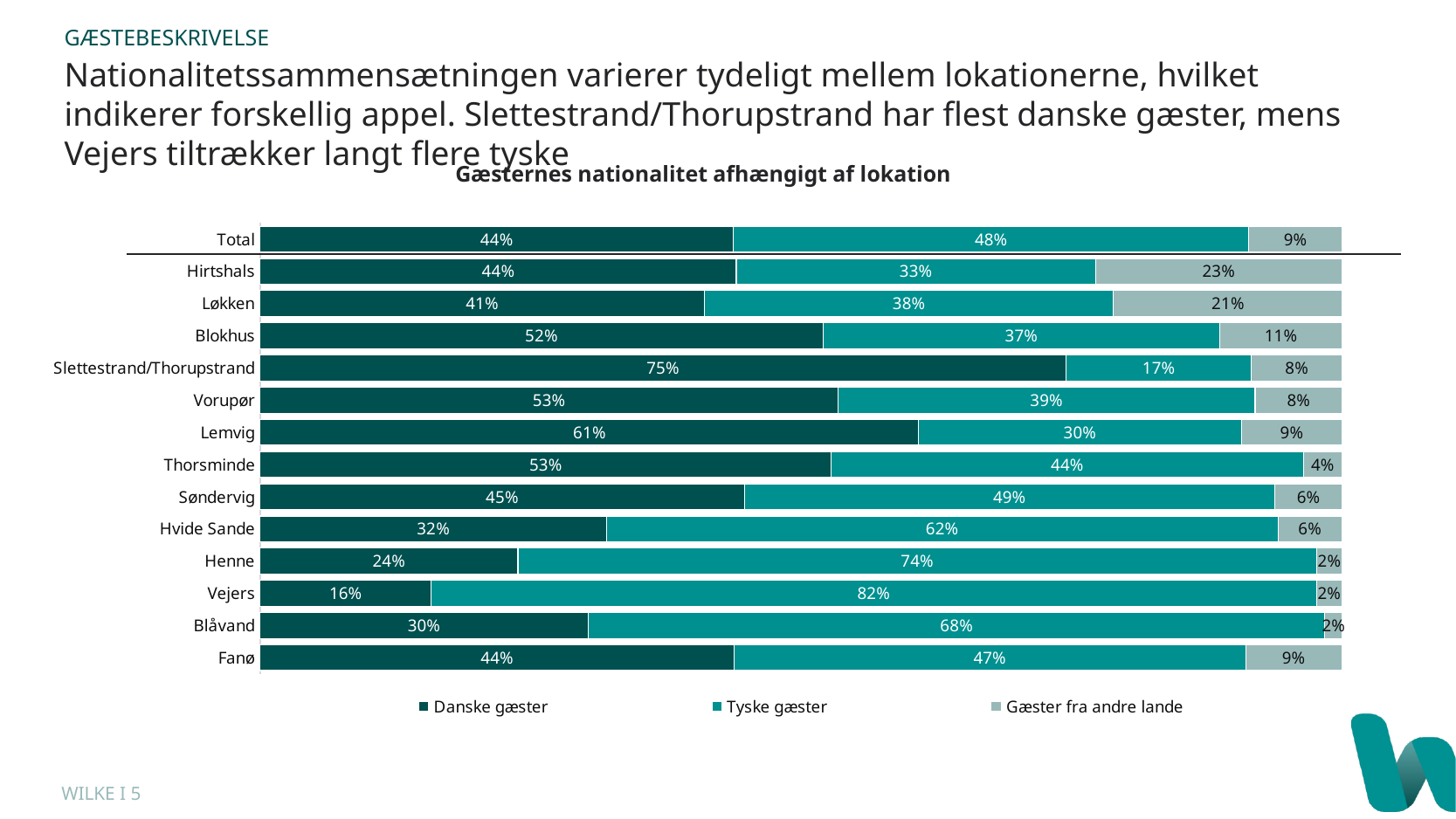
Which location has the highest share of Danske gæster? Slettestrand/Thorupstrand What share of guests at Slettestrand/Thorupstrand are Danske gæster? 75% How many series does the legend list? 3 Which location has the highest share of Tyske gæster? Vejers What is the title of the chart? Gæsternes nationalitet afhængigt af lokation What share of guests at Vejers are Tyske gæster? 82% What kind of chart is shown on the slide? Stacked bar chart Which location has the lowest share of Danske gæster? Vejers What is the difference in percentage points between Tyske gæster and Danske gæster at Vejers? 66 percentage points How many bars (rows) are shown in the chart, including Total? 14 What share of guests at Hirtshals are Gæster fra andre lande? 23% Which has a larger share of Tyske gæster, Hvide Sande or Blåvand? Blåvand